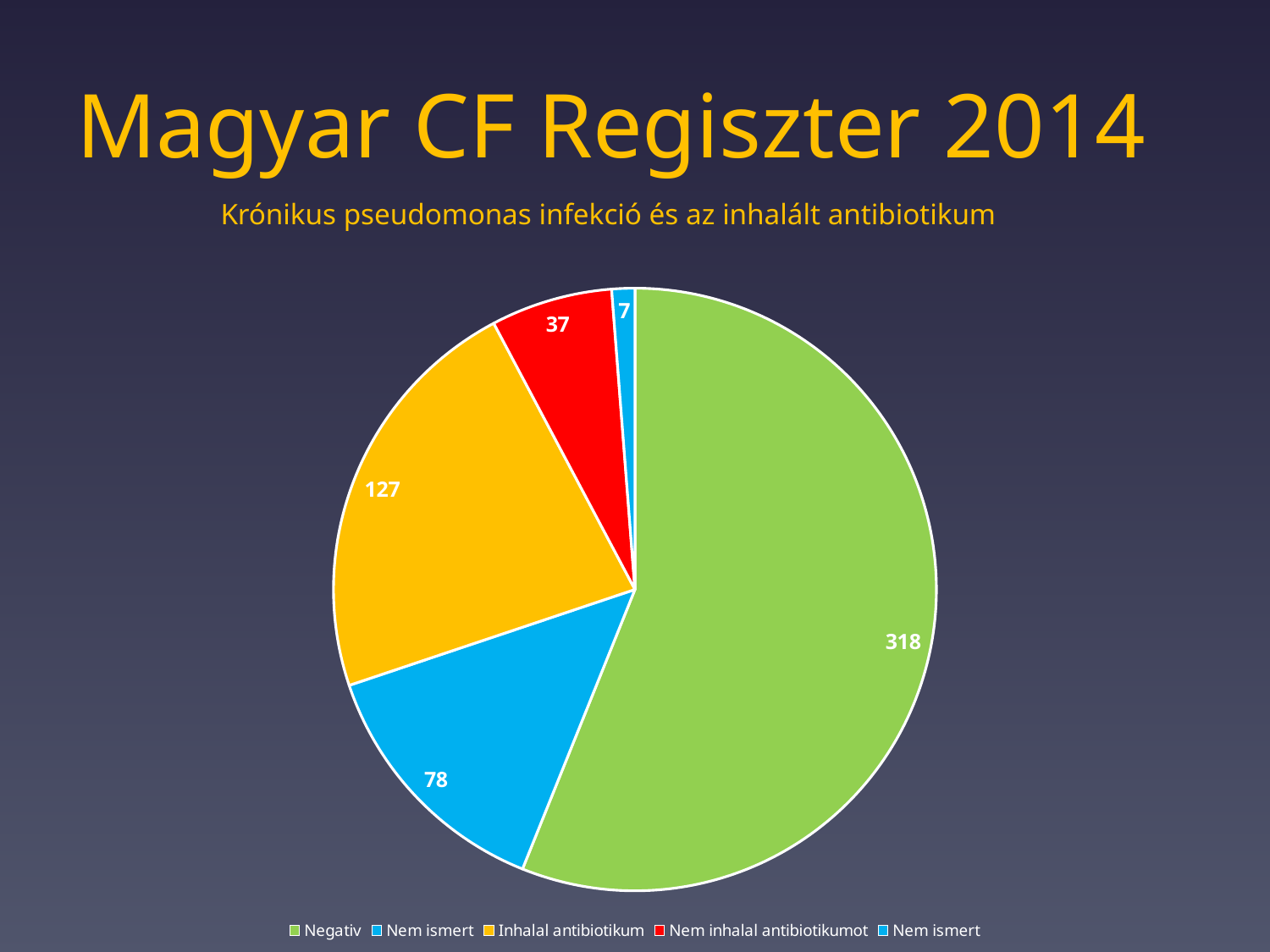
What is the subtitle shown above the chart? Krónikus pseudomonas infekció és az inhalált antibiotikum What is the value of the smallest slice, at the top of the pie? 7 What is the difference between the Inhalal antibiotikum value and the Nem inhalal antibiotikumot value? 90 Which is larger, Inhalal antibiotikum or Nem inhalal antibiotikumot? Inhalal antibiotikum What is the difference between the Negativ value and the Inhalal antibiotikum value? 191 How many entries does the legend list? 5 What is the value of the Nem inhalal antibiotikumot slice? 37 What is the value of the Inhalal antibiotikum slice? 127 Which category has the largest slice? Negativ What type of chart is shown on the slide? pie chart What is the value of the Negativ slice? 318 How many slices does the pie chart have? 5